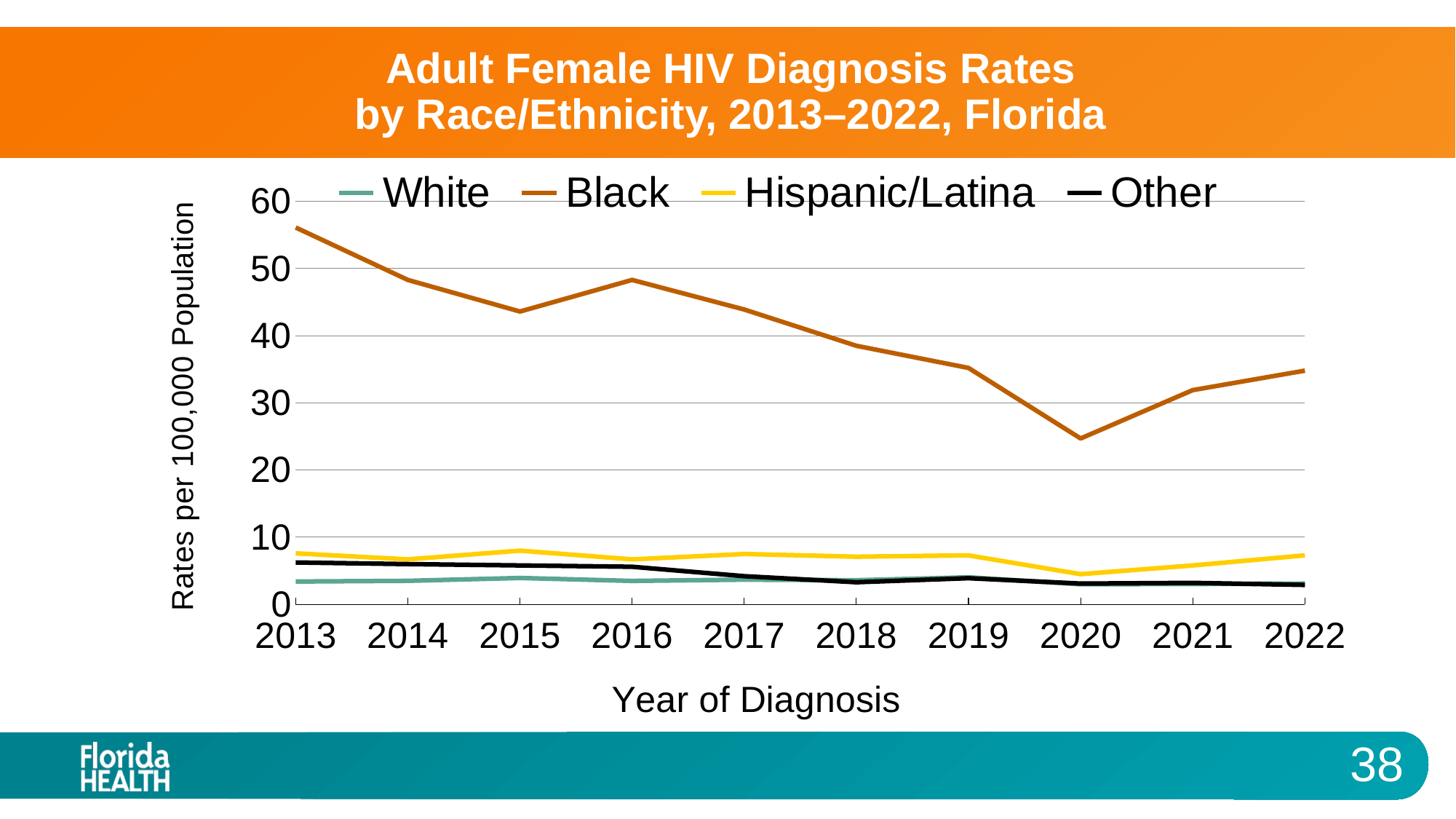
Is the rate for Hispanic/Latina adult females in 2015 greater or less than 10? less What kind of chart is shown on the slide? line chart How many years are plotted along the x axis? 10 In 2013, which is larger: the rate for Hispanic/Latina or the rate for White adult females? Hispanic/Latina How many series does the legend list? 4 Is the rate for Black adult females in 2013 greater or less than 50? greater In which year is the rate for Black adult females at its highest? 2013 Which race/ethnicity group has the highest diagnosis rate across the whole period? Black Does the rate for Black adult females rise or fall from 2013 to 2020? fall Is the rate for Black adult females in 2020 greater or less than 30? less What is the label on the y axis? Rates per 100,000 Population In which year is the rate for Black adult females at its lowest? 2020